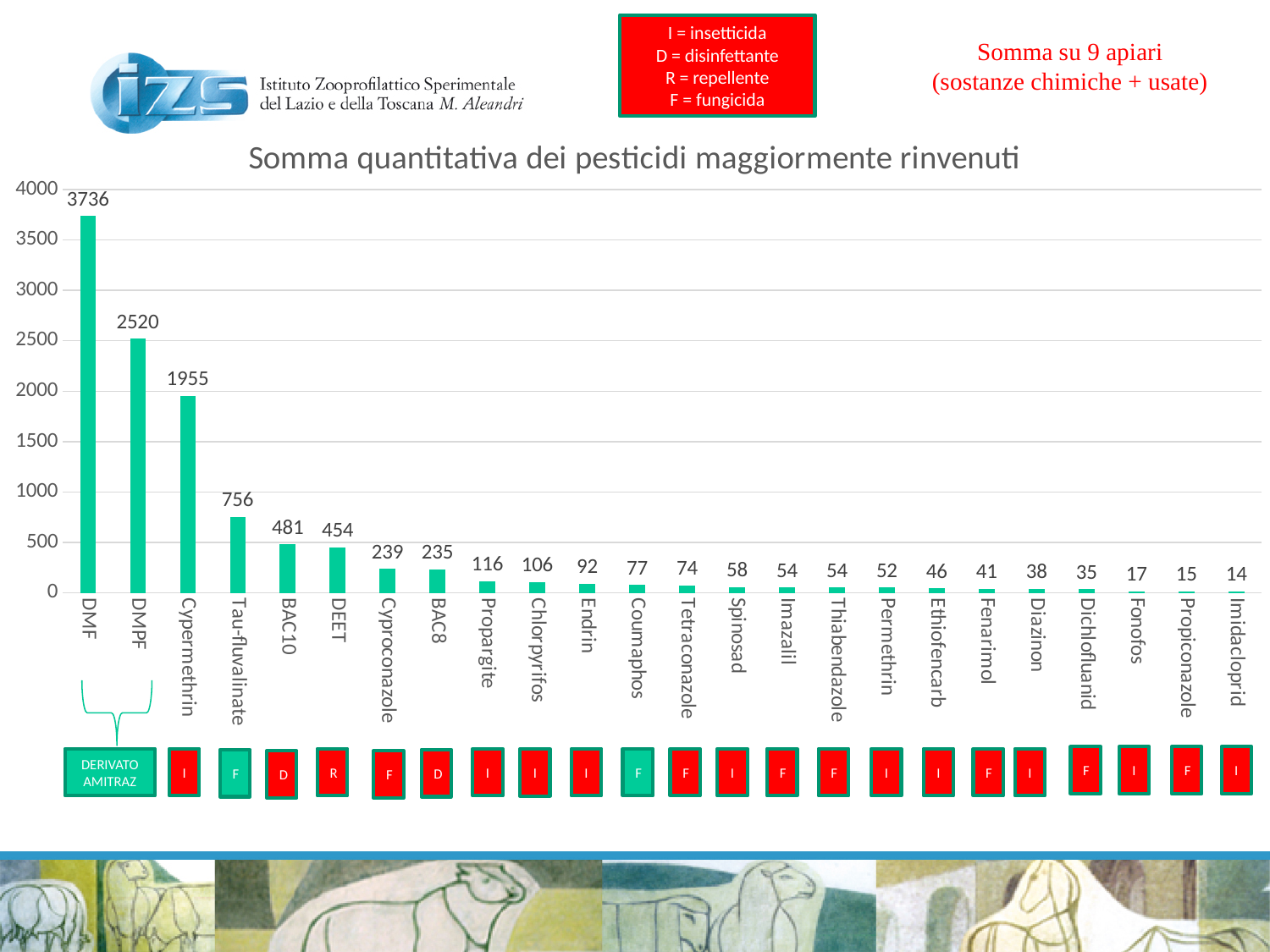
What is the value for Chlorpyrifos? 106 What is the value for Cypermethrin? 1955 How many categories are shown on the x axis? 24 Which category has the lowest value? Imidacloprid What is the value for DMF? 3736 Is the value for DMPF greater or less than 2000? greater Which category has the highest value? DMF What is the difference between the values for DMF and DMPF? 1216 What is the title of the chart? Somma quantitativa dei pesticidi maggiormente rinvenuti What is the value for Tau-fluvalinate? 756 What kind of chart is shown on the slide? bar chart Which is larger, the value for BAC10 or the value for DEET? BAC10